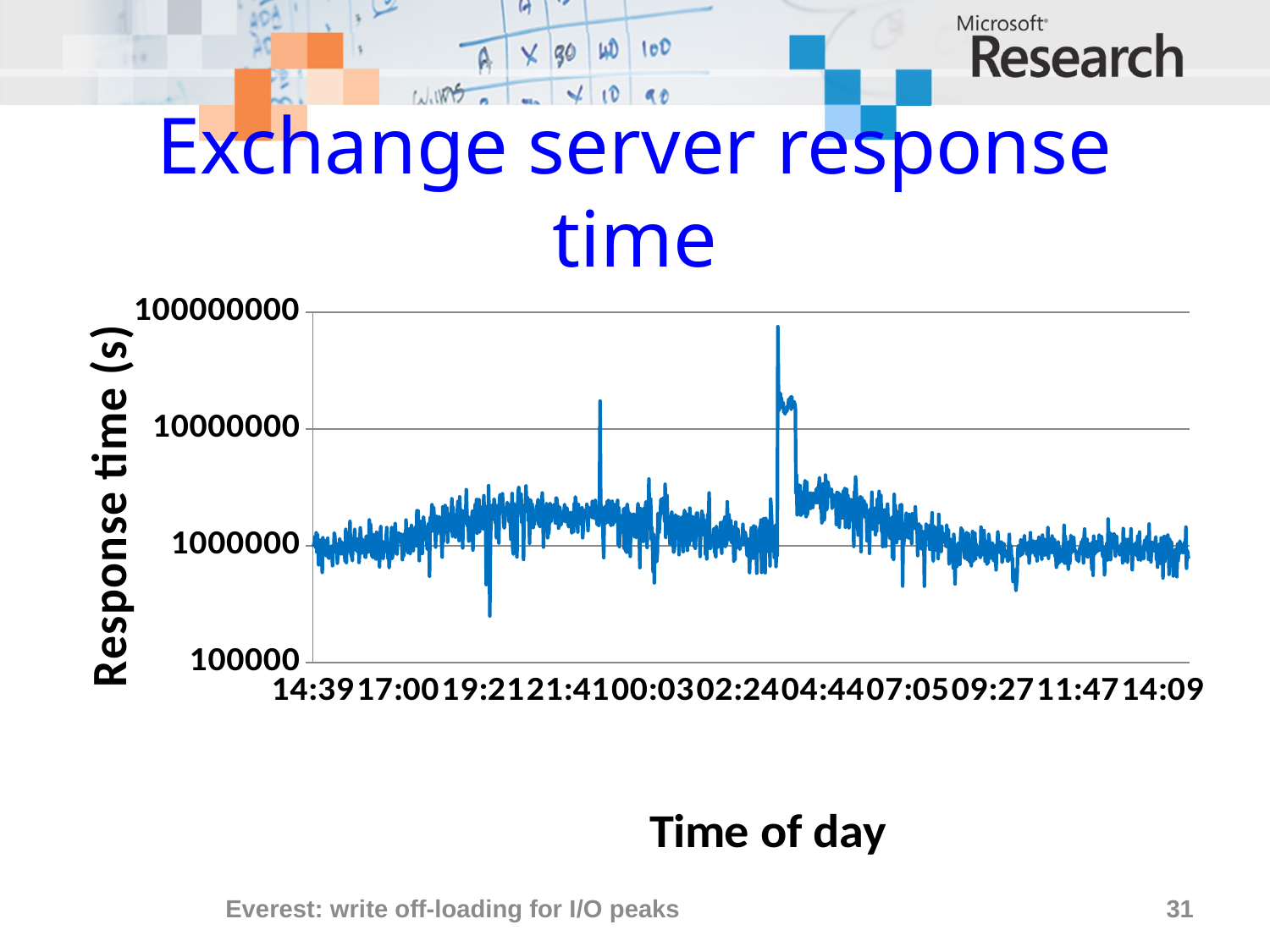
What is the label of the x-axis? Time of day Is the largest response-time spike, which occurs shortly before 04:44, greater or less than 10000000? greater What is the first time-of-day label on the x-axis? 14:39 What is the title of the chart on the slide? Exchange server response time What is the label of the y-axis? Response time (s) What is the last time-of-day label on the x-axis? 14:09 Around which x-axis time label does the largest response-time spike occur? 04:44 What is the highest value shown on the y-axis? 100000000 What kind of chart is shown on the slide? line chart How many time-of-day tick labels are shown on the x-axis? 11 Is the lowest dip in response time, which occurs shortly before 19:21, greater or less than 1000000? less What is the lowest value shown on the y-axis? 100000